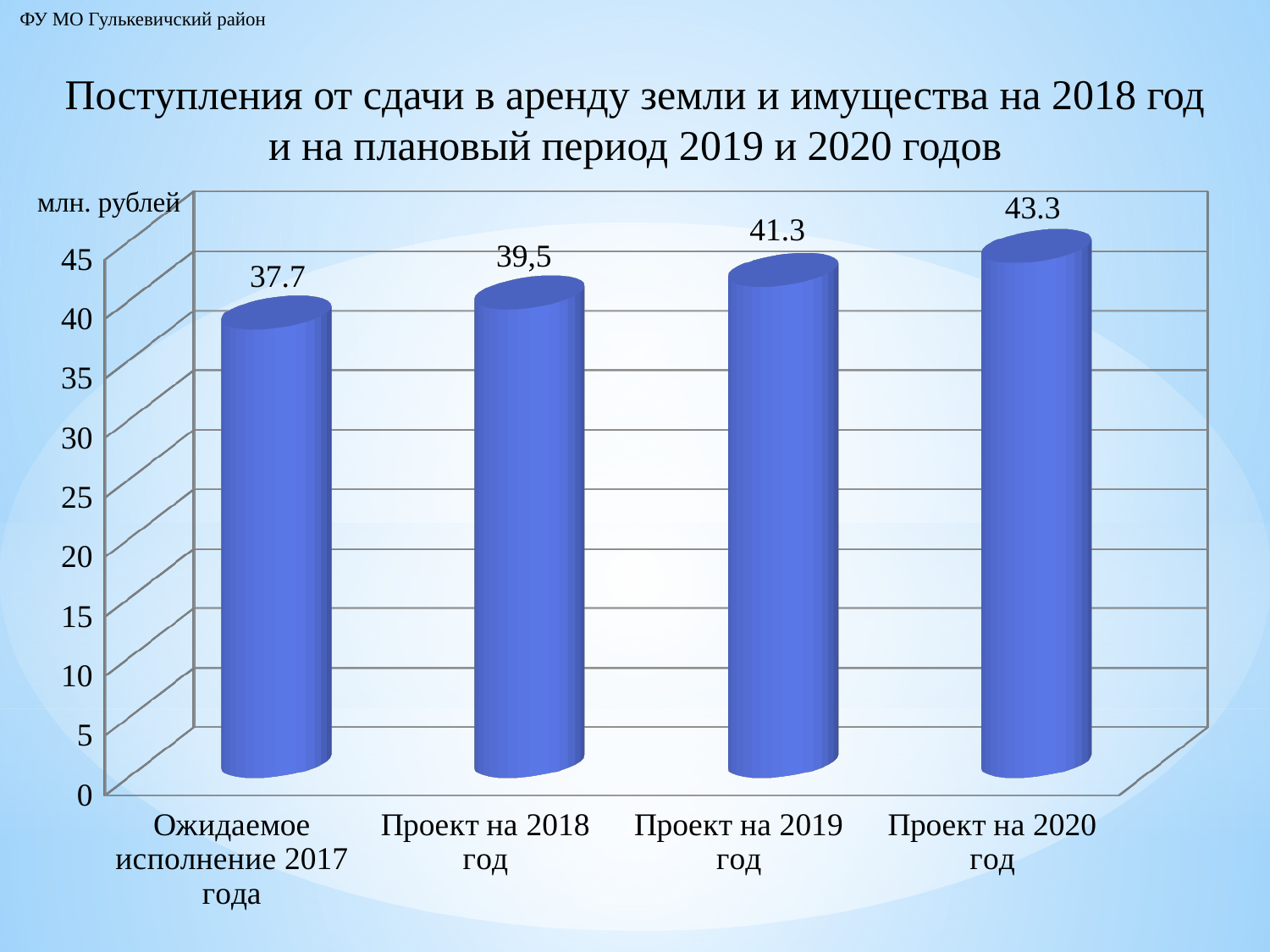
What is the difference between the values for Проект на 2019 год and Проект на 2018 год? 1.8 What is the value for Проект на 2018 год? 39,5 How many categories are shown on the chart? 4 Do the values rise or fall from left to right along the x axis? Rise What is the value for Проект на 2020 год? 43.3 Which category has the highest value? Проект на 2020 год What is the difference between the values for Проект на 2020 год and Ожидаемое исполнение 2017 года? 5.6 What kind of chart is shown on the slide? Bar chart What is the value for Ожидаемое исполнение 2017 года? 37.7 What is the value for Проект на 2019 год? 41.3 Which is larger, the value for Проект на 2019 год or the value for Проект на 2018 год? Проект на 2019 год Which category has the lowest value? Ожидаемое исполнение 2017 года